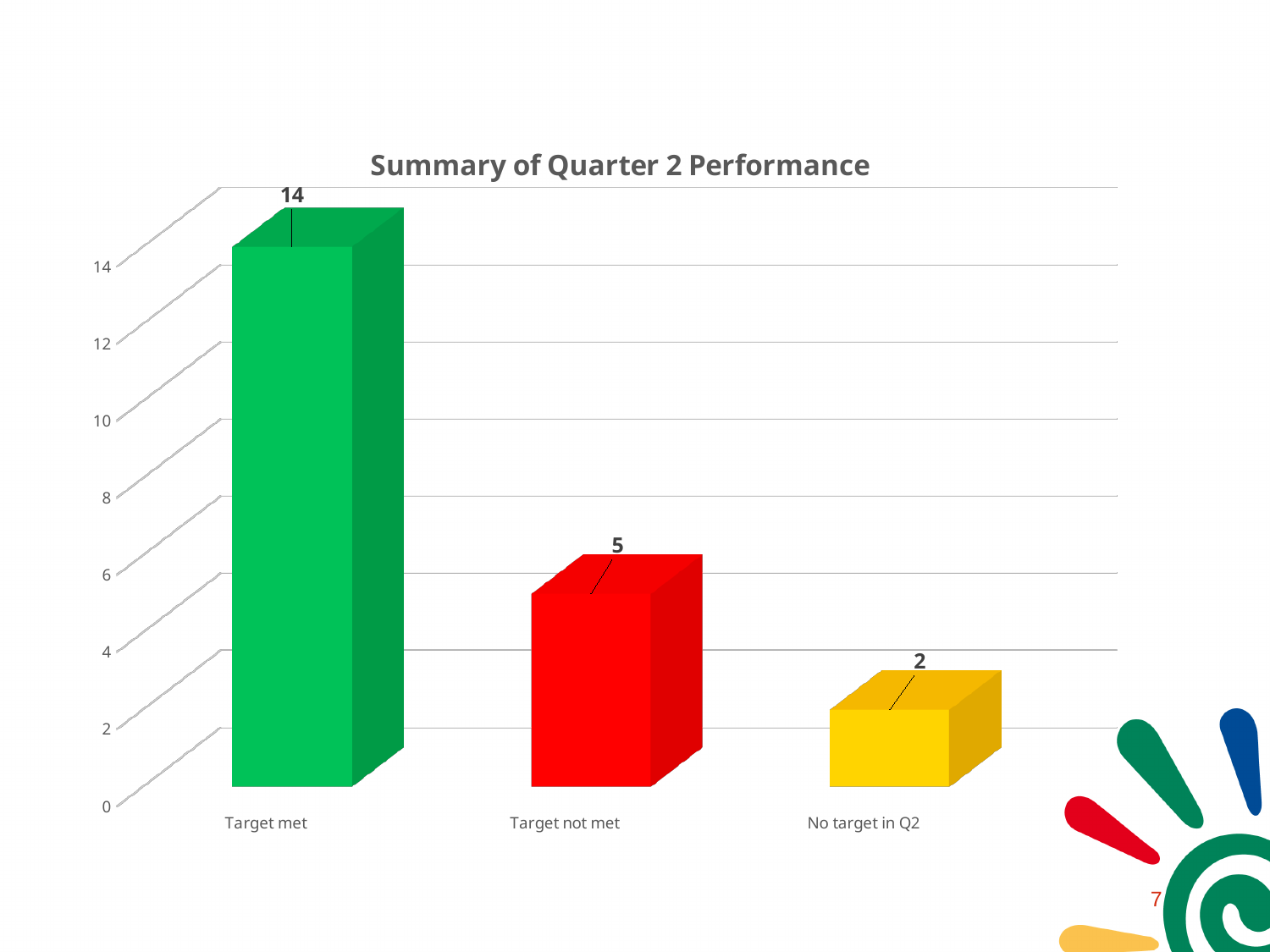
Do the values rise or fall from left to right along the x axis? Fall How many categories are shown on the chart? 3 What is the difference between the values for Target not met and No target in Q2? 3 What kind of chart is shown on the slide? Bar chart Which is larger, the value for Target not met or the value for No target in Q2? Target not met What is the value for No target in Q2? 2 What is the value for Target not met? 5 What is the value for Target met? 14 What is the title of the chart? Summary of Quarter 2 Performance What is the difference between the values for Target met and Target not met? 9 Which category has the highest value? Target met Which category has the lowest value? No target in Q2